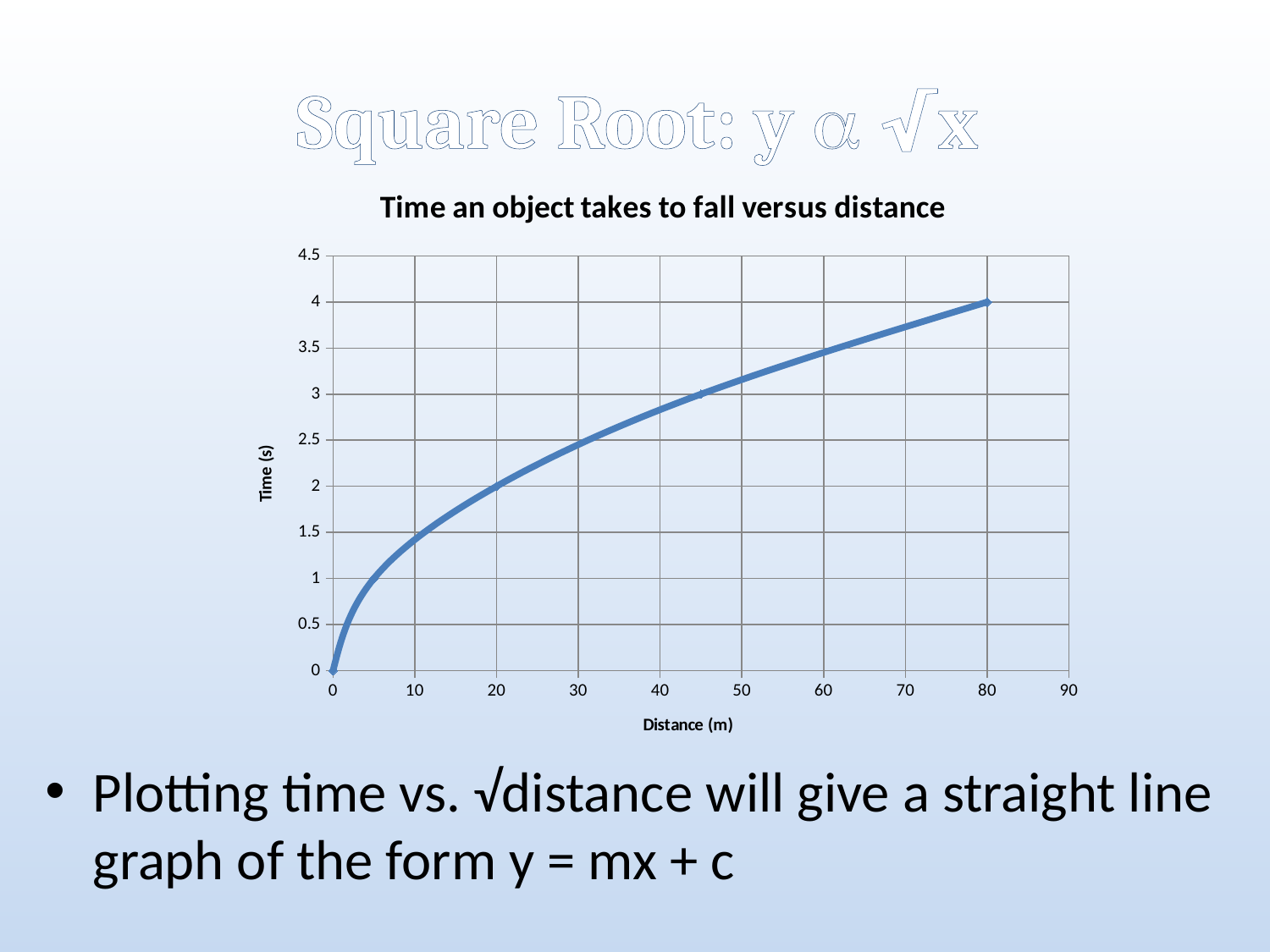
What is the time value where the curve ends at a distance of 80 m? 4 Which distance has the higher time value, 20 m or 80 m? 80 m What is the title of the chart? Time an object takes to fall versus distance Is the time value at a distance of 40 m greater or less than 2.5? greater Is the time value at a distance of 70 m greater or less than 3.5? greater What is the time value at a distance of 20 m? 2 Does the time rise or fall as distance increases along the x axis? rises What is the time value at a distance of 0 m? 0 Is the time value at a distance of 40 m greater or less than 3? less What is the label of the vertical axis? Time (s) What kind of chart is shown on the slide? line chart